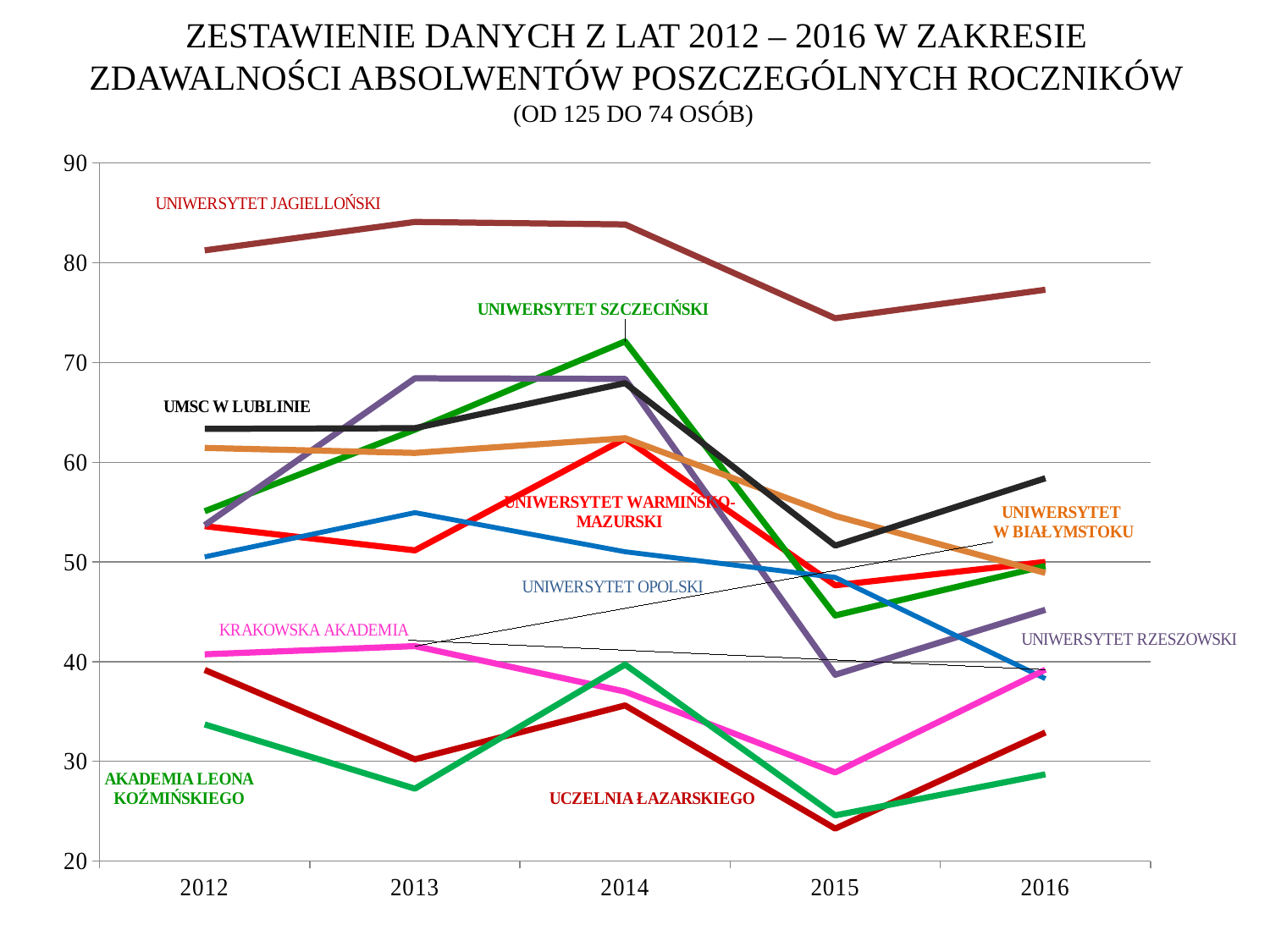
Is the value for Uniwersytet Jagielloński in 2015 greater or less than 80? less Does the value for Uniwersytet Jagielloński rise or fall from 2014 to 2015? fall Is the value for Uniwersytet Jagielloński in 2012 greater or less than 80? greater What is the lowest value shown on the y axis of the chart? 20 Which university has the highest value in 2012? Uniwersytet Jagielloński Is the value for Uczelnia Łazarskiego in 2015 greater or less than 30? less Which university has the lowest value in 2012? Akademia Leona Koźmińskiego How many universities (series) are labelled on the chart? 10 In 2014, which is higher: Uniwersytet Szczeciński or UMSC w Lublinie? Uniwersytet Szczeciński What kind of chart is shown on the slide? line chart How many years are shown on the x axis of the chart? 5